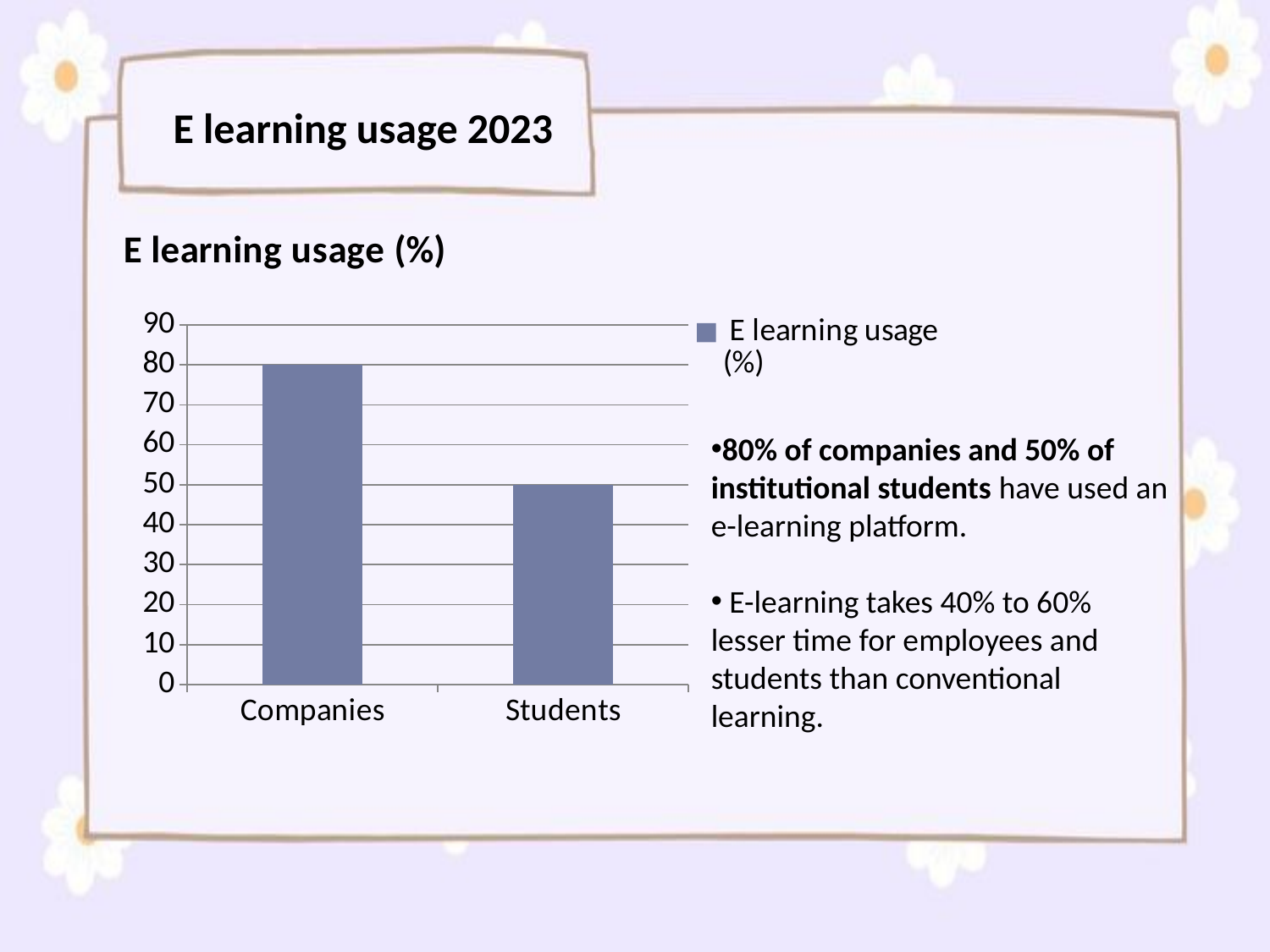
Is the value for Companies greater or less than 70? greater Which has a larger E learning usage value, Companies or Students? Companies Which category has the highest E learning usage? Companies What is the title of the chart? E learning usage (%) What is the E learning usage (%) value for Companies? 80 What kind of chart is shown on the slide? bar chart What is the E learning usage (%) value for Students? 50 How many series does the chart legend list? 1 How many categories are shown on the x axis of the chart? 2 Which category has the lowest E learning usage? Students What is the difference between the E learning usage values for Companies and Students? 30 Is the value for Students greater or less than 60? less